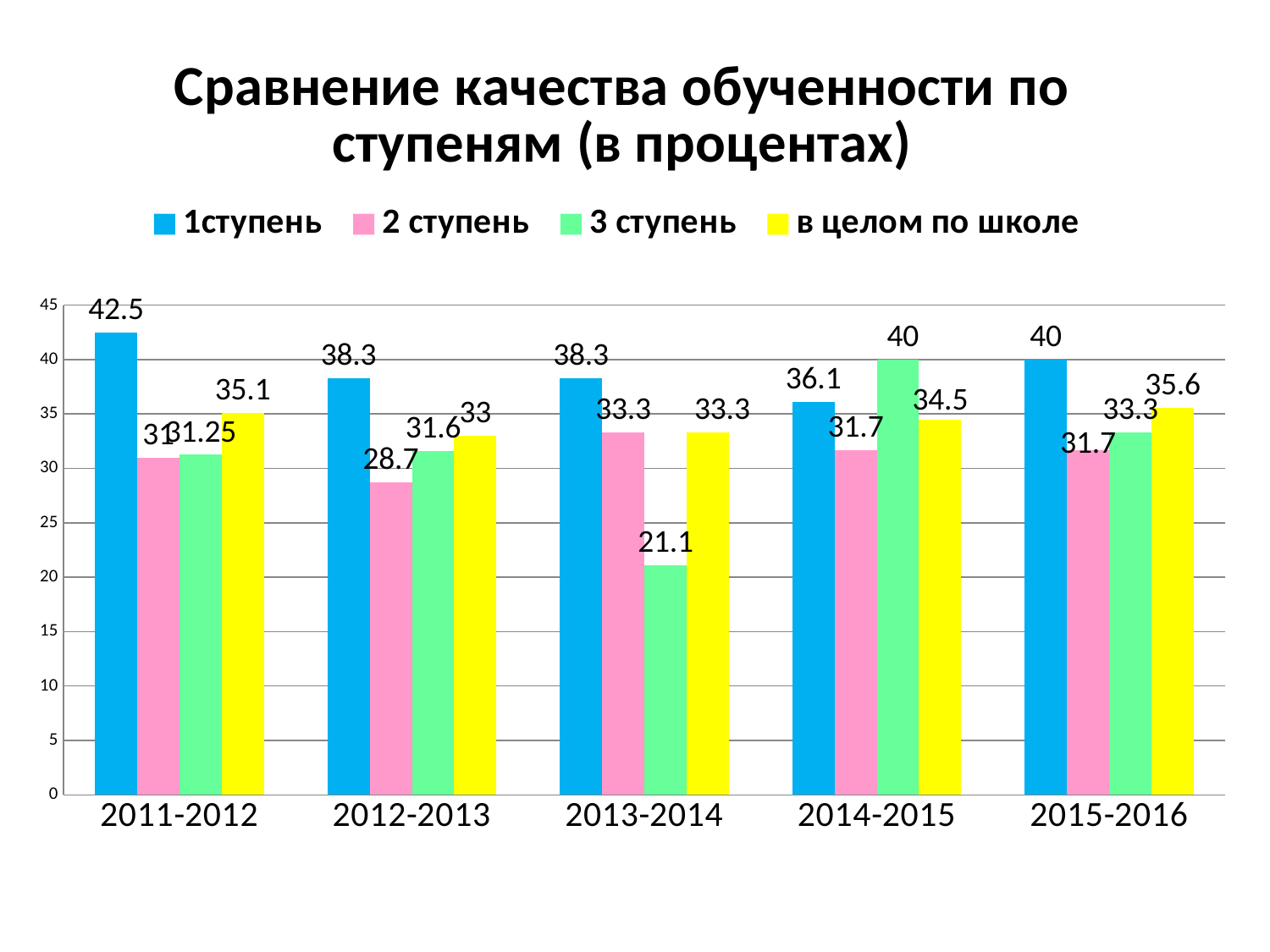
What is the difference between the 1ступень values for 2011-2012 and 2012-2013? 4.2 In which school year is the value for 3 ступень the lowest? 2013-2014 What is the value for 3 ступень in 2013-2014? 21.1 In 2014-2015, which is larger: the value for 1ступень or for 3 ступень? 3 ступень What is the value for в целом по школе in 2015-2016? 35.6 What is the value for 1ступень in 2011-2012? 42.5 In which school year is the value for 1ступень the highest? 2011-2012 How many series does the legend list? 4 Does the value for в целом по школе rise or fall from 2012-2013 to 2015-2016? rise What kind of chart is shown on the slide? bar chart How many school years are shown on the x axis? 5 What is the value for 2 ступень in 2012-2013? 28.7